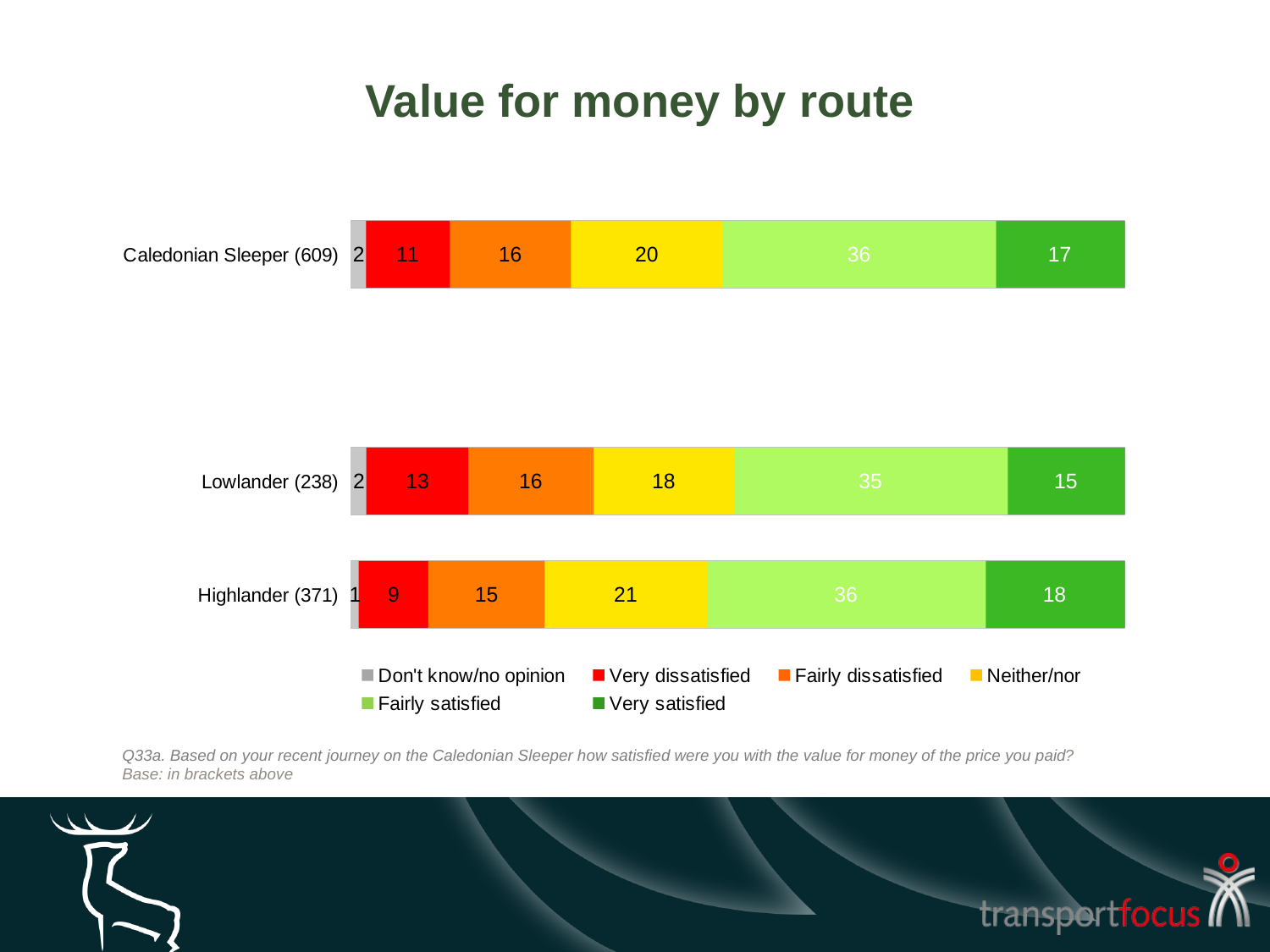
How many routes (categories) are plotted in the chart? 3 What is the Very dissatisfied value for Caledonian Sleeper (609)? 11 What is the Fairly satisfied value for Lowlander (238)? 35 Which route has the highest Very dissatisfied value? Lowlander (238) What is the total of the stacked bar for Highlander (371)? 100 What kind of chart is shown on the slide? Stacked bar chart What is the Neither/nor value for Highlander (371)? 21 What is the difference between the Very dissatisfied values for Lowlander (238) and Highlander (371)? 4 How many series does the legend list? 6 What is the Very satisfied value for Highlander (371)? 18 Which is larger, the Neither/nor value for Caledonian Sleeper (609) or for Lowlander (238)? Caledonian Sleeper (609) Which route has the lowest Very satisfied value? Lowlander (238)